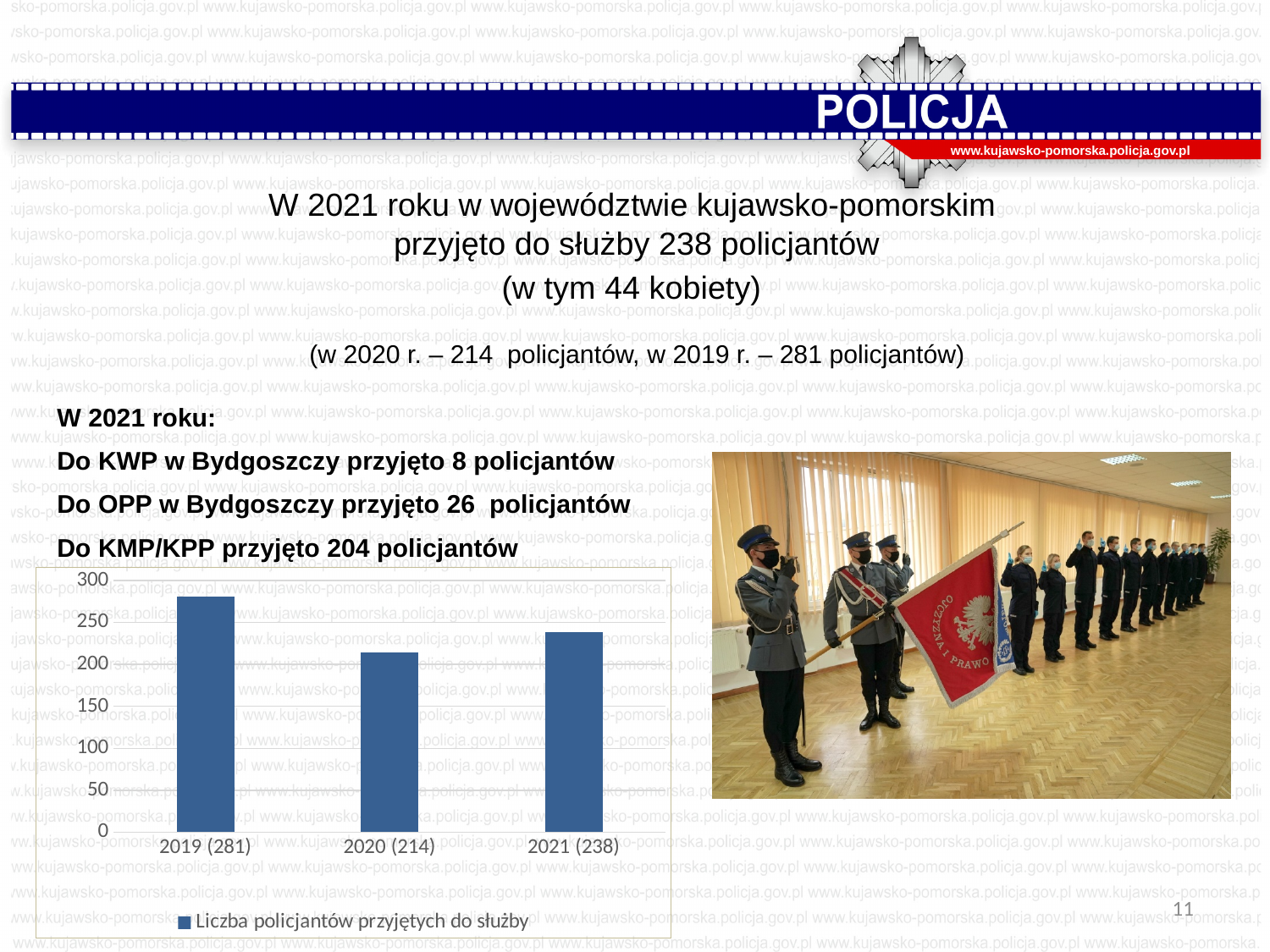
How many series does the chart legend list? 1 What is the difference between the values for 2019 and 2020? 67 Which year has the lowest bar in the chart? 2020 Which is larger, the value for 2021 or the value for 2020? 2021 What is the value for 2019 in the chart? 281 Is the value for 2021 greater or less than 250? less What is the value for 2020 in the chart? 214 What kind of chart is shown on the slide? bar chart What is the legend entry of the chart? Liczba policjantów przyjętych do służby What is the value for 2021 in the chart? 238 How many bars does the chart have? 3 Which year has the highest bar in the chart? 2019